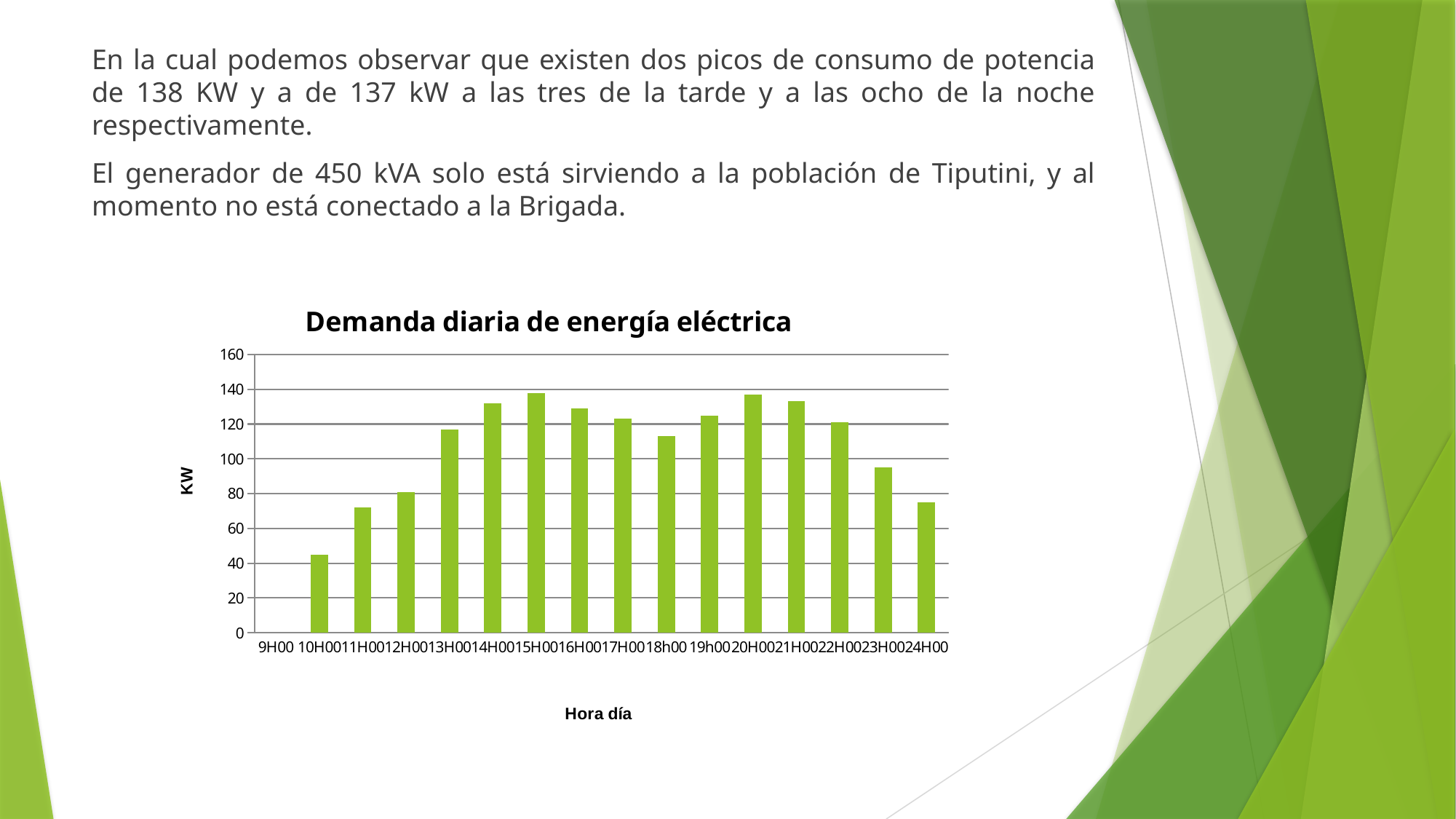
Is the value for 24H00 greater or less than 80? less Do the values rise or fall from 10H00 to 15H00? rise What is the label of the vertical axis of the chart? KW Which hour has the highest bar in the chart? 15H00 Which hour has the lowest bar in the chart? 10H00 Which is larger, the value for 13H00 or the value for 17H00? 17H00 Which is larger, the value for 22H00 or the value for 24H00? 22H00 Is the value for 10H00 greater or less than 60? less What is the title of the chart? Demanda diaria de energía eléctrica What type of chart is shown on the slide? bar chart Is the value for 23H00 greater or less than 100? less